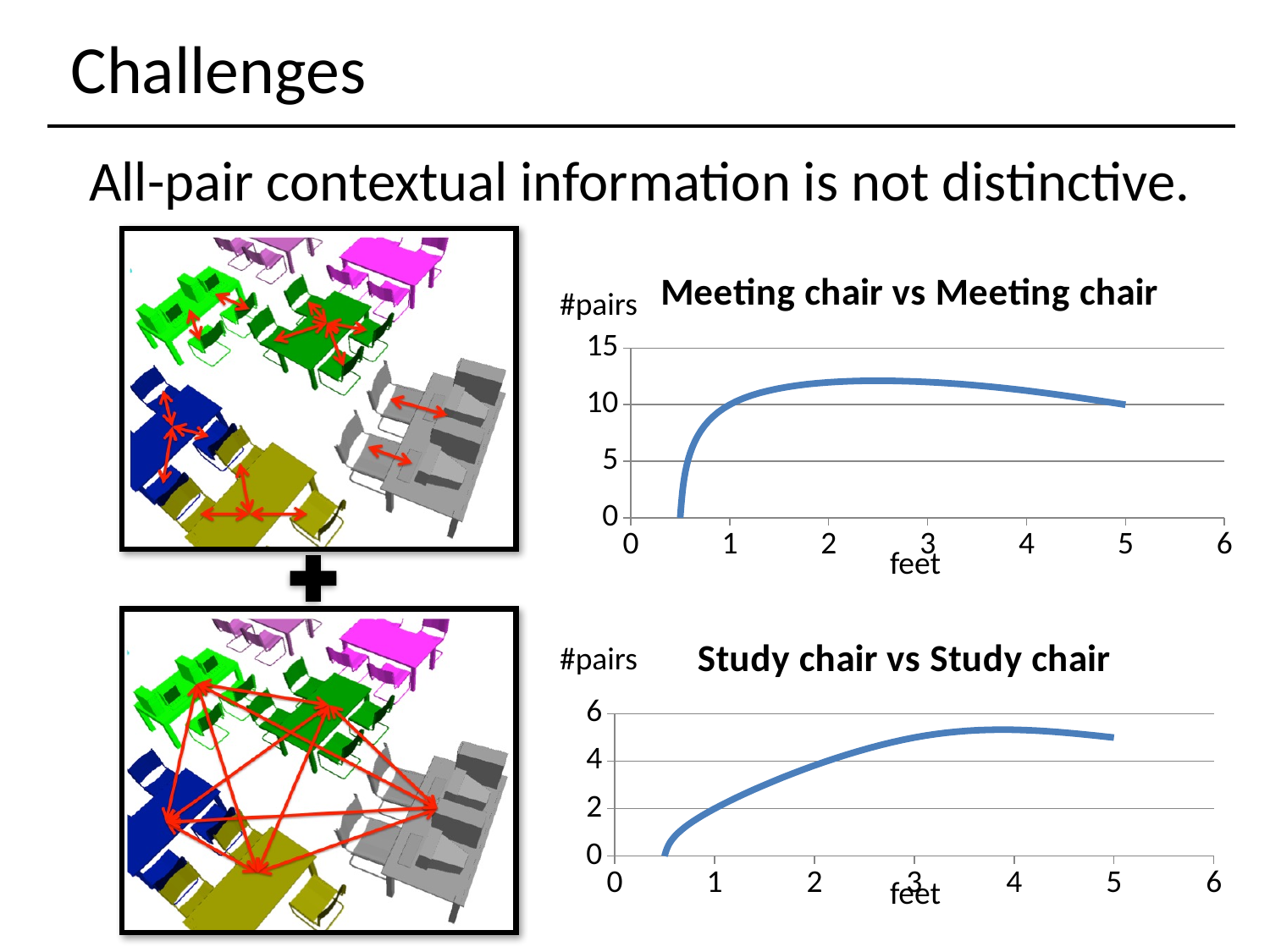
In the 'Meeting chair vs Meeting chair' chart, is the value at 2 feet greater or less than 10? greater What is the x-axis label of the 'Study chair vs Study chair' chart? feet In the 'Study chair vs Study chair' chart, is the value at 5 feet greater or less than 6? less In the 'Meeting chair vs Meeting chair' chart, which is larger: the value at 2 feet or the value at 5 feet? 2 feet In the 'Meeting chair vs Meeting chair' chart, is the value at 1 feet greater or less than 15? less In the 'Study chair vs Study chair' chart, does the number of pairs rise or fall between 1 feet and 3 feet? rise In the 'Meeting chair vs Meeting chair' chart, does the number of pairs rise or fall between 3 feet and 5 feet? fall What kind of chart is the 'Meeting chair vs Meeting chair' chart? line chart What is the title of the top chart on the slide? Meeting chair vs Meeting chair What kind of chart is the 'Study chair vs Study chair' chart? line chart